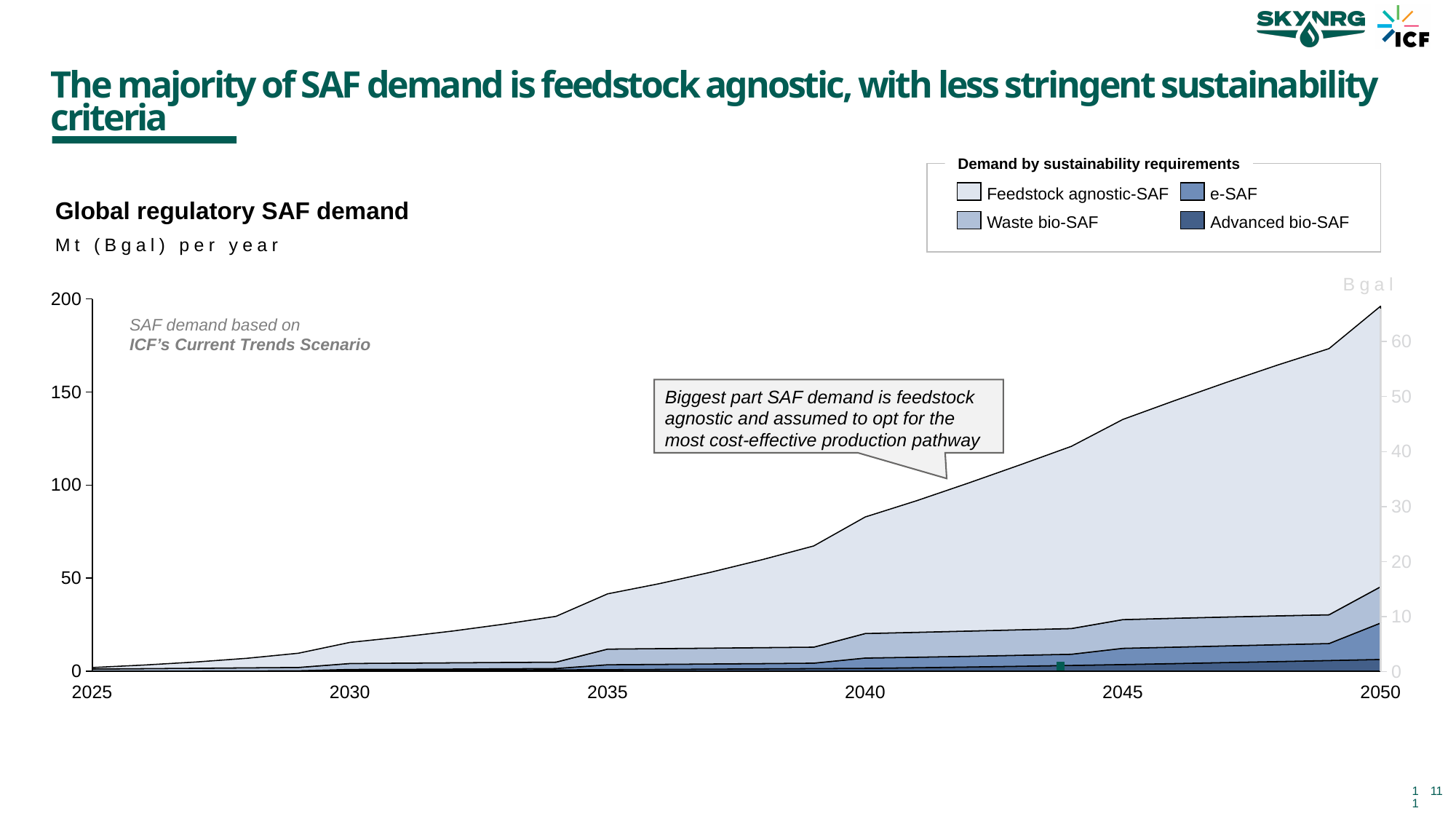
Is the total SAF demand in 2035 greater or less than 50? less What is the title of the chart? Global regulatory SAF demand How many series does the legend list? 4 How many year labels are shown on the x axis? 6 Is the total SAF demand in 2030 greater or less than 50? less Does total SAF demand rise or fall from 2025 to 2050? Rise Is the total SAF demand in 2050 greater or less than 150? greater What unit is given for the left axis of the chart? Mt (Bgal) per year What kind of chart is shown on the slide? Stacked area chart Which series accounts for the largest share of SAF demand in 2050? Feedstock agnostic-SAF